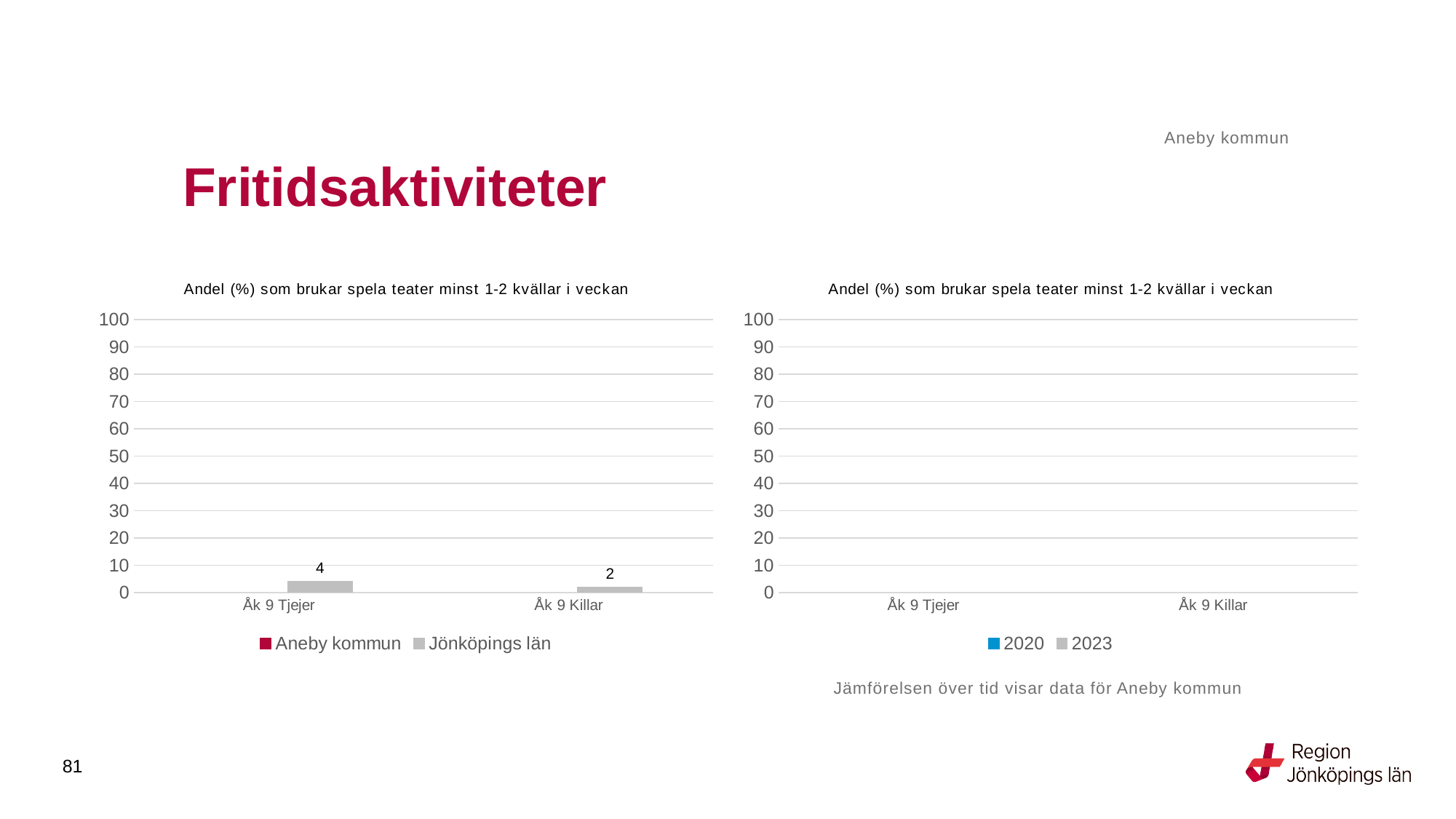
On the left chart, how many categories are shown on the x axis? 2 On the left chart, what is the value for Jönköpings län for Åk 9 Killar? 2 What kind of chart is the left chart? bar chart On the left chart, which category has the lowest value for Jönköpings län? Åk 9 Killar On the left chart, which category has the highest value for Jönköpings län? Åk 9 Tjejer On the left chart, what is the value for Jönköpings län for Åk 9 Tjejer? 4 On the left chart, how many series does the legend list? 2 On the left chart, which is larger for Jönköpings län: Åk 9 Tjejer or Åk 9 Killar? Åk 9 Tjejer On the left chart, what is the difference between the Jönköpings län values for Åk 9 Tjejer and Åk 9 Killar? 2 On the right chart, what are the legend entries? 2020, 2023 On the right chart, how many series does the legend list? 2 On the left chart, is the value for Jönköpings län for Åk 9 Tjejer greater or less than 10? less